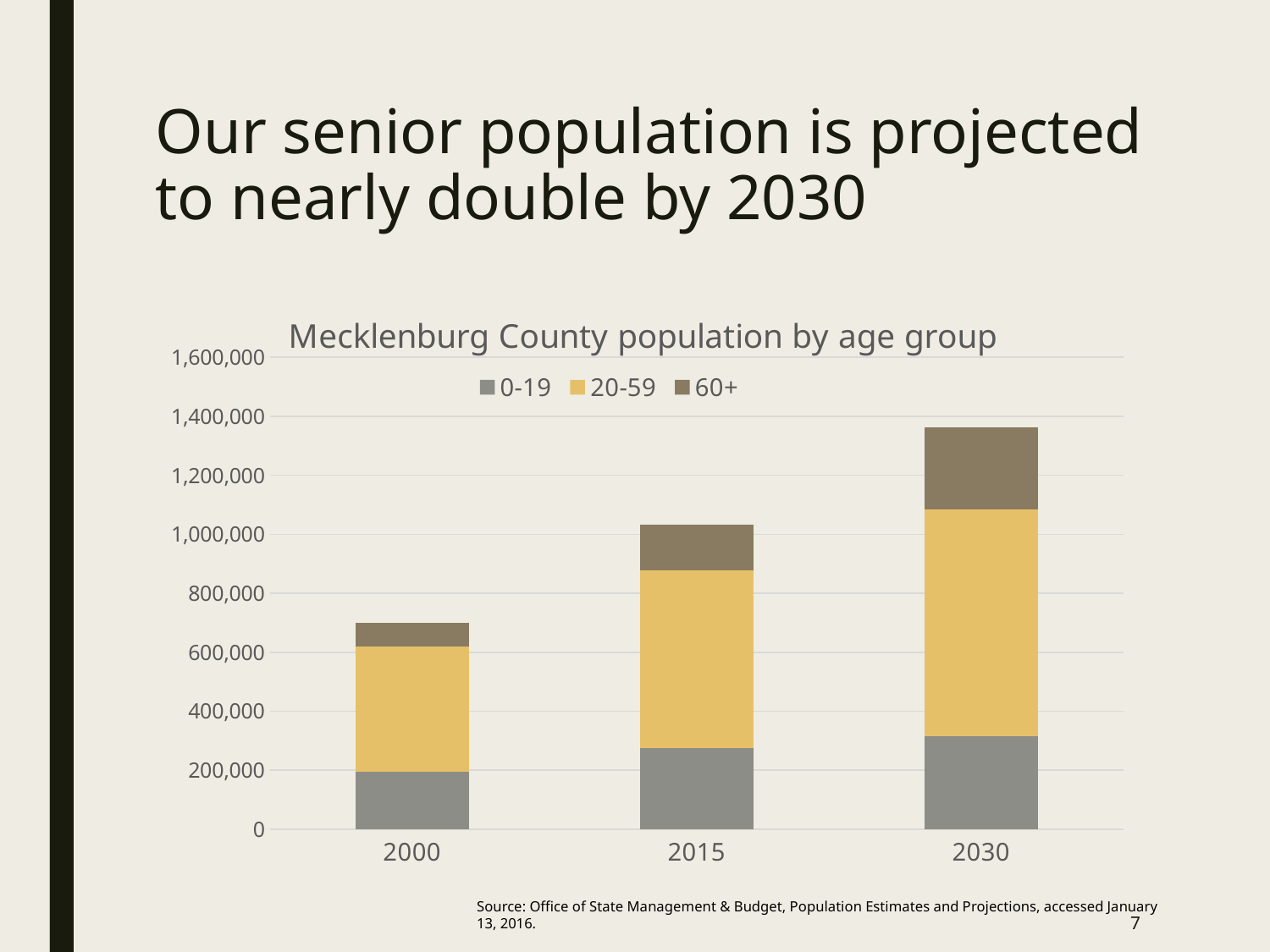
Is the total bar height for 2030 greater or less than 1,200,000? greater Is the total bar height for 2030 greater or less than 1,400,000? less How many series does the legend list? 3 What is the title of the chart? Mecklenburg County population by age group Which legend entry is shown in yellow? 20-59 Do the total bar heights rise or fall from 2000 to 2030? rise What kind of chart is shown on the slide? bar chart Which year has the shortest stacked bar? 2000 Which is larger, the total bar for 2030 or the total bar for 2000? 2030 Which year has the tallest stacked bar? 2030 Is the value for the 0-19 group in 2030 greater or less than 400,000? less How many years are shown on the x axis? 3